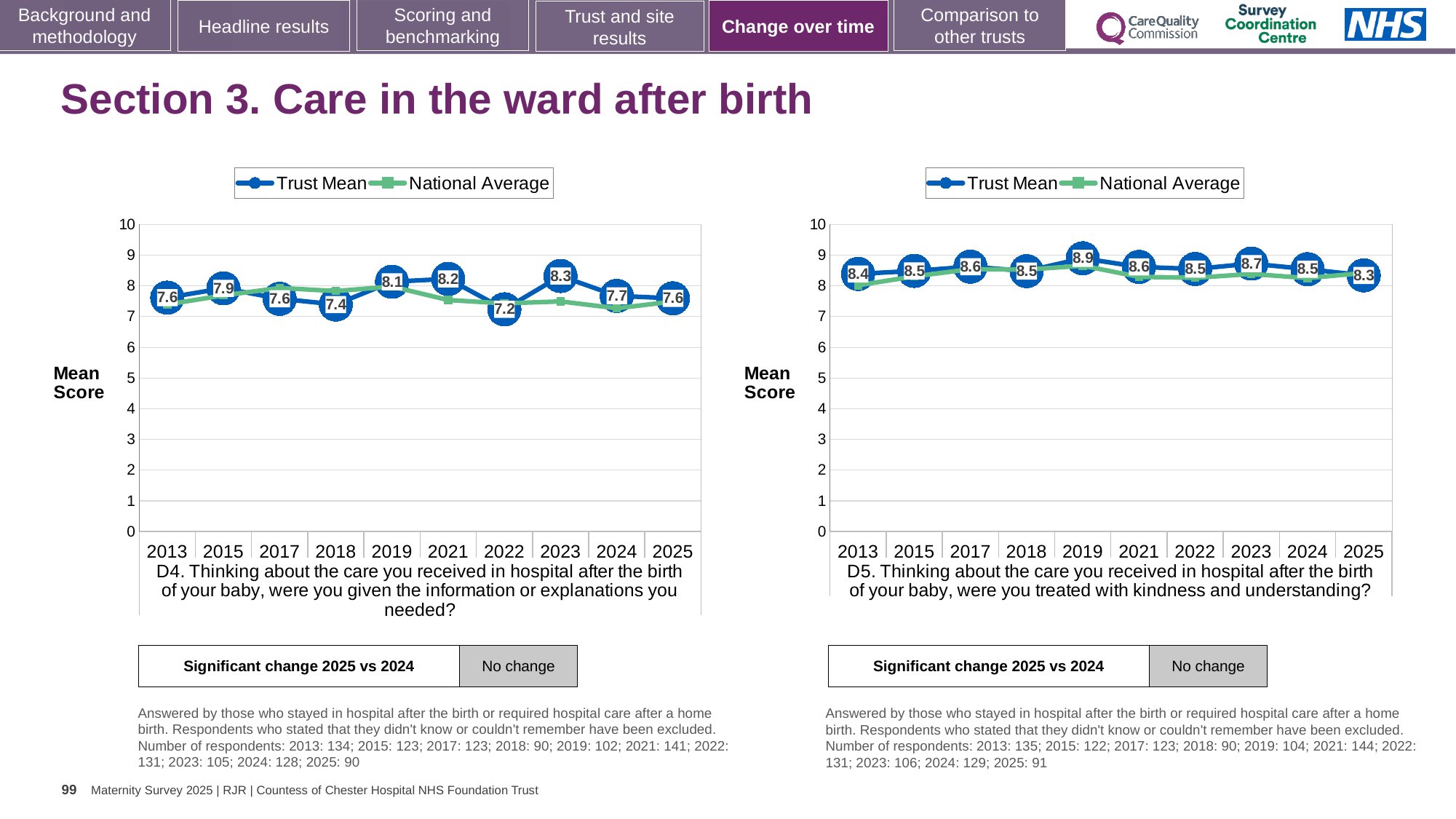
How many years are plotted on the x axis of the left chart (D4)? 10 How many series does the legend of the right chart (D5) list? 2 On the right chart (D5), what is the difference between the Trust Mean scores for 2019 and 2025? 0.6 What type of chart is the left chart (D4)? line chart On the right chart (D5), what is the Trust Mean score for 2025? 8.3 On the left chart (D4), what is the Trust Mean score for 2022? 7.2 On the left chart (D4), which year has the lowest Trust Mean score? 2022 On the left chart (D4), which year has the highest Trust Mean score? 2023 On the right chart (D5), which year has the highest Trust Mean score? 2019 On the left chart (D4), is the Trust Mean score for 2021 higher or lower than for 2024? higher On the right chart (D5), what is the Trust Mean score for 2019? 8.9 On the left chart (D4), what is the Trust Mean score for 2023? 8.3